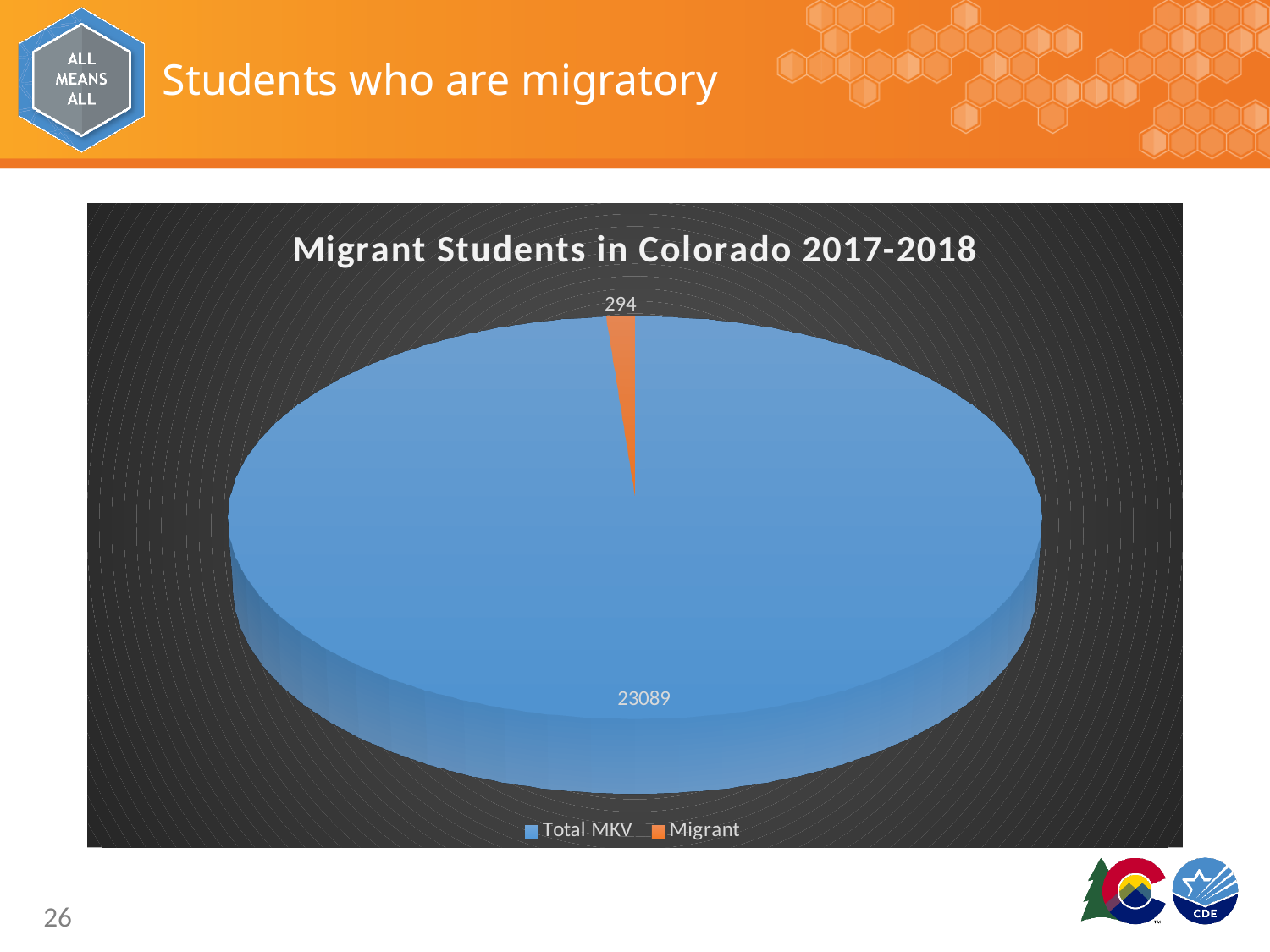
What type of chart is shown on the slide? pie chart What is the value for Total MKV in the pie chart? 23089 What is the sum of the two values shown in the pie chart? 23383 Which is larger, Total MKV or Migrant? Total MKV Which slice of the pie chart is the largest? Total MKV How many entries does the legend list? 2 What is the difference between the Total MKV value and the Migrant value? 22795 What is the title of the pie chart? Migrant Students in Colorado 2017-2018 How many slices does the pie chart have? 2 Which slice of the pie chart is the smallest? Migrant What is the value for Migrant in the pie chart? 294 What colour is the Migrant slice in the pie chart? orange